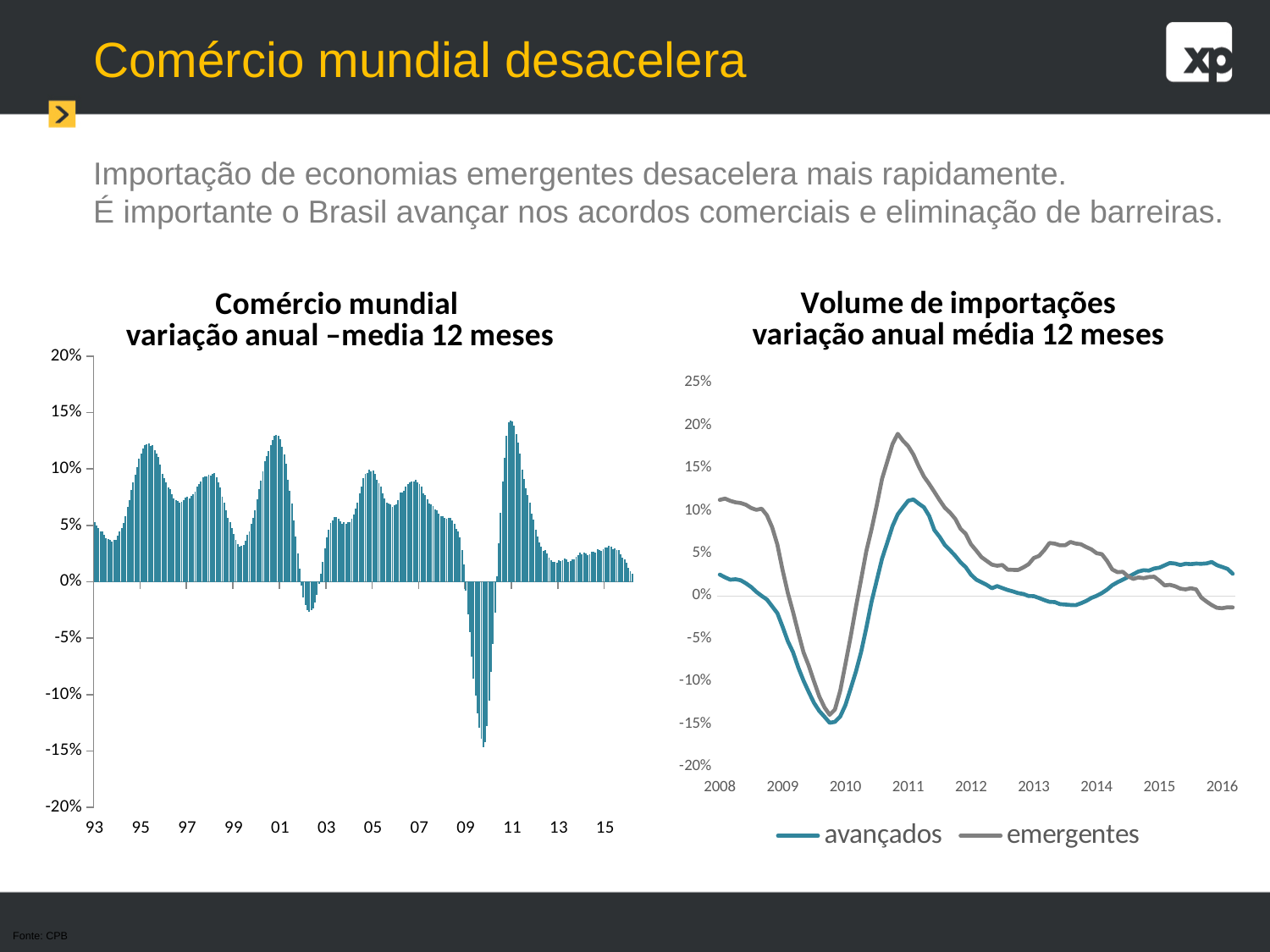
What are the two series named in the legend of the 'Volume de importações' chart? avançados and emergentes In the 'Volume de importações' chart, at the end of the series in 2016, which line is higher, avançados or emergentes? avançados What kind of chart is the 'Comércio mundial variação anual – media 12 meses' chart on the left? bar chart In the 'Comércio mundial' bar chart, is the lowest bar around 2009 greater or less than -10%? less In the 'Comércio mundial' bar chart, do the bars rise or fall between 2011 and 2013? fall In the 'Volume de importações' chart, which series is drawn in grey? emergentes In the 'Volume de importações' chart, is the emergentes value at the end of 2016 greater or less than 0%? less How many series does the legend of the 'Volume de importações' chart list? 2 In the 'Volume de importações' chart, is the peak value of the emergentes line around 2010–2011 greater or less than 15%? greater In the 'Volume de importações' chart, at the start of 2008, which series has the higher value, avançados or emergentes? emergentes What kind of chart is the 'Volume de importações variação anual média 12 meses' chart on the right? line chart